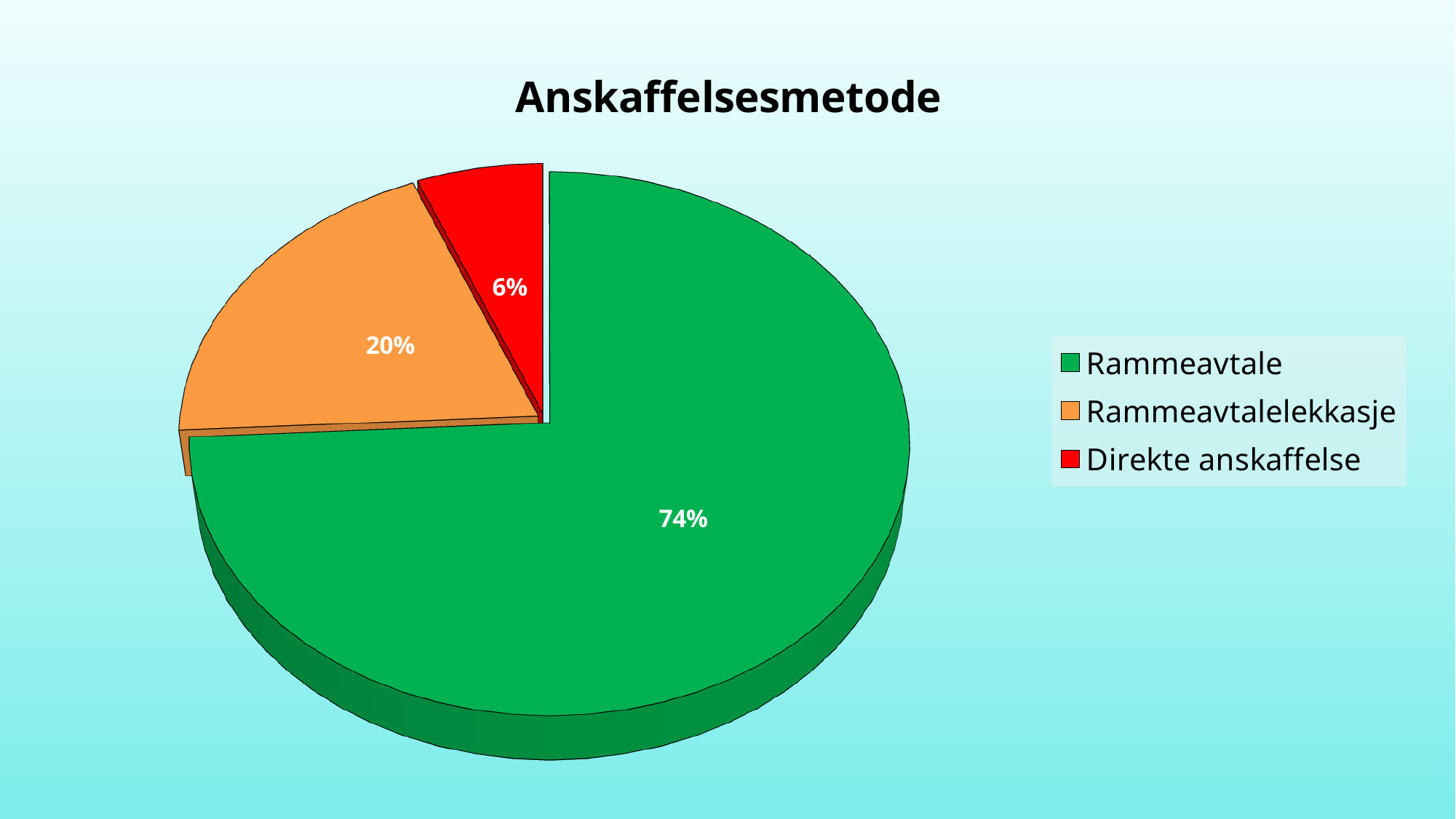
What colour is the Direkte anskaffelse slice? red What kind of chart is shown on the slide? pie chart Which is larger, Rammeavtalelekkasje or Direkte anskaffelse? Rammeavtalelekkasje Which category has the largest slice? Rammeavtale What share of the pie does Rammeavtale have? 74% What is the difference in percentage points between Rammeavtale and Rammeavtalelekkasje? 54 How many categories does the pie chart show? 3 What is the difference in percentage points between Rammeavtalelekkasje and Direkte anskaffelse? 14 Which category has the smallest slice? Direkte anskaffelse What is the title of the chart? Anskaffelsesmetode What share of the pie does Direkte anskaffelse have? 6% What share of the pie does Rammeavtalelekkasje have? 20%